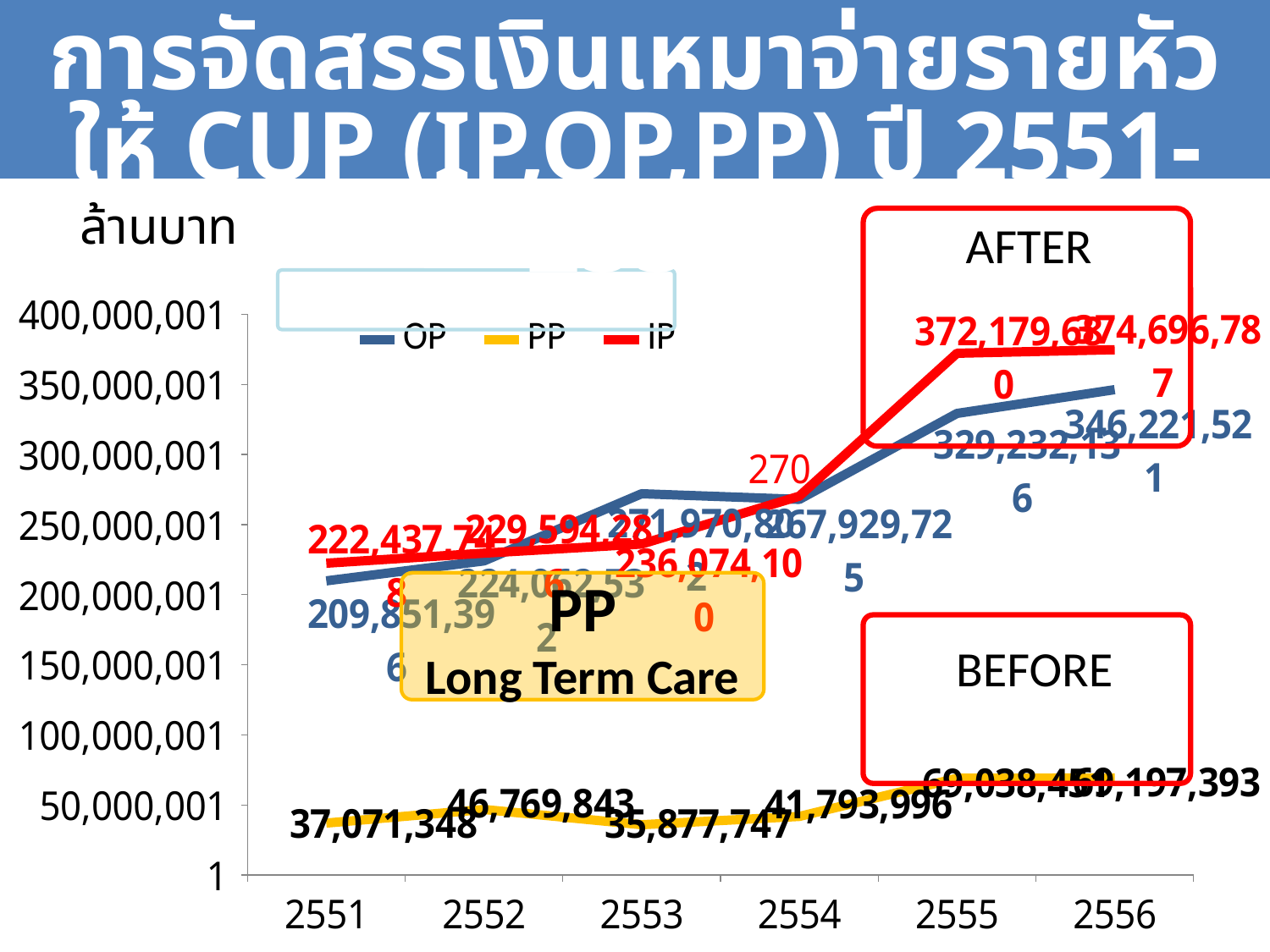
Which series has the lowest values across all years? PP Is the IP value for 2555 greater or less than 350,000,001? greater What type of chart is shown on the slide? line chart In 2556, which is larger, the OP value or the IP value? IP How many years are shown on the x axis? 6 What are the three entries in the chart legend? OP, PP, IP How many series does the legend list? 3 What is the difference between the OP value in 2556 and the OP value in 2555? 16,989,385 What is the PP value for 2551? 37,071,348 What is the IP value for 2556? 374,696,787 What is the OP value for 2555? 329,232,136 Does the OP series rise or fall overall from 2551 to 2556? rise